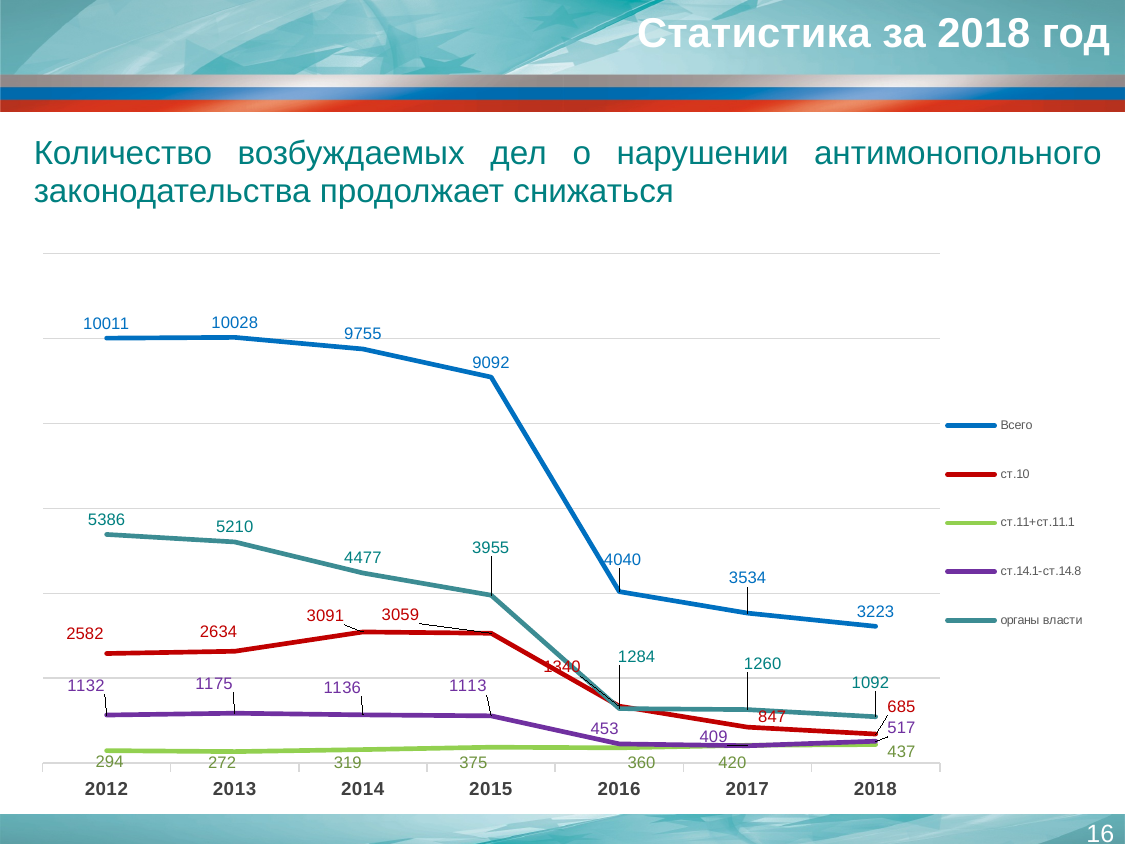
In which year is the Всего series at its highest? 2013 Does the Всего series rise or fall from 2013 to 2018? fall What is the value of the ст.14.1-ст.14.8 series in 2017? 409 In which year is the ст.11+ст.11.1 series at its lowest? 2013 In 2018, which is larger: the ст.10 value or the ст.14.1-ст.14.8 value? ст.10 How many years are plotted along the x axis? 7 What is the value of the Всего series in 2018? 3223 What colour is the line for the Всего series? blue What is the difference between the Всего values for 2015 and 2016? 5052 What kind of chart is shown on the slide? line chart What is the value of the органы власти series in 2014? 4477 How many series does the legend list? 5